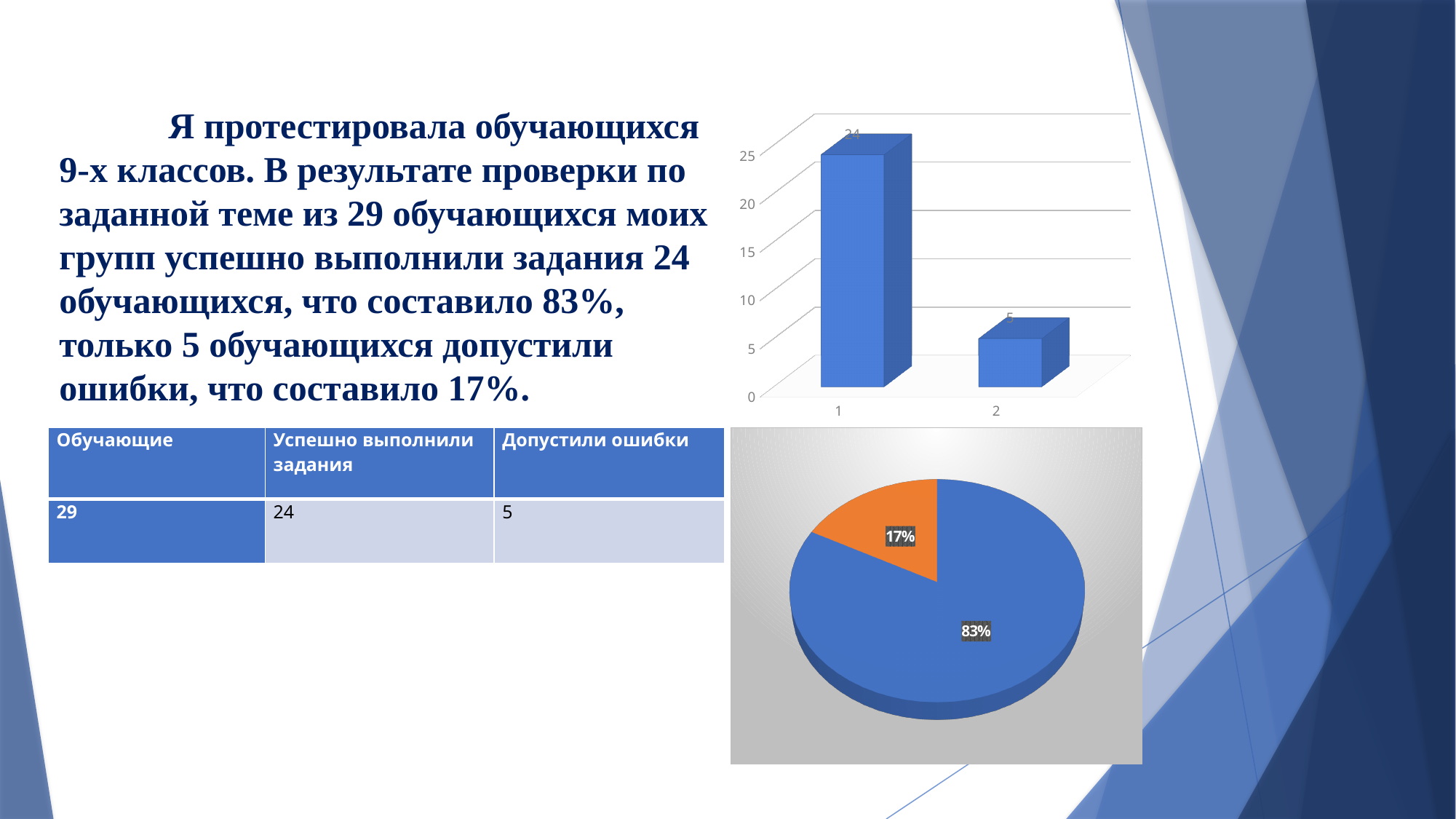
What kind of chart is shown at the bottom right of the slide? pie chart In the pie chart at the bottom right, what share does the blue slice represent? 83% In the bar chart at the top right, what is the difference between the values for category 1 and category 2? 19 In the pie chart at the bottom right, which slice is larger, the blue one or the orange one? the blue one In the bar chart at the top right, is the value for category 2 greater or less than 10? less In the bar chart at the top right, what is the value for category 1? 24 In the bar chart at the top right, which category has the highest value? 1 What kind of chart is shown at the top right of the slide? bar chart In the pie chart at the bottom right, what share does the orange slice represent? 17% In the bar chart at the top right, what is the value for category 2? 5 In the bar chart at the top right, which category has the lowest value? 2 In the bar chart at the top right, how many bars are plotted? 2